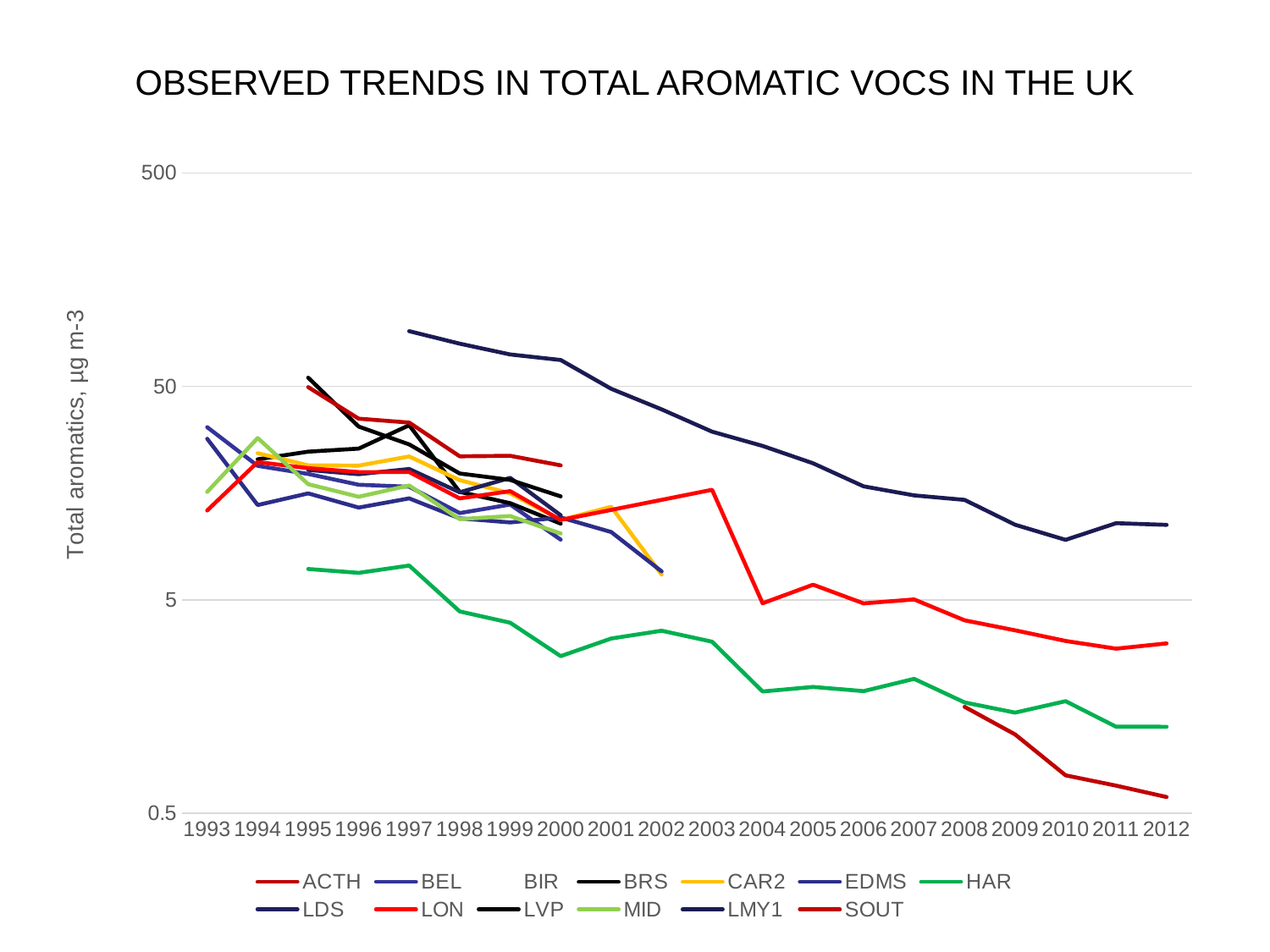
How many series does the legend list? 13 Is the value for LON in 2003 greater or less than 5? greater Which series has the highest value in 2012? LMY1 What kind of chart is shown on the slide? line chart Is the value for HAR in 2012 greater or less than 5? less Does the LMY1 series rise or fall from 1997 to 2012? fall Is the value for LMY1 in 2012 greater or less than 5? greater How many years are shown along the x axis? 20 What is the label on the y axis? Total aromatics, µg m-3 Which series has the lowest value in 2012? ACTH